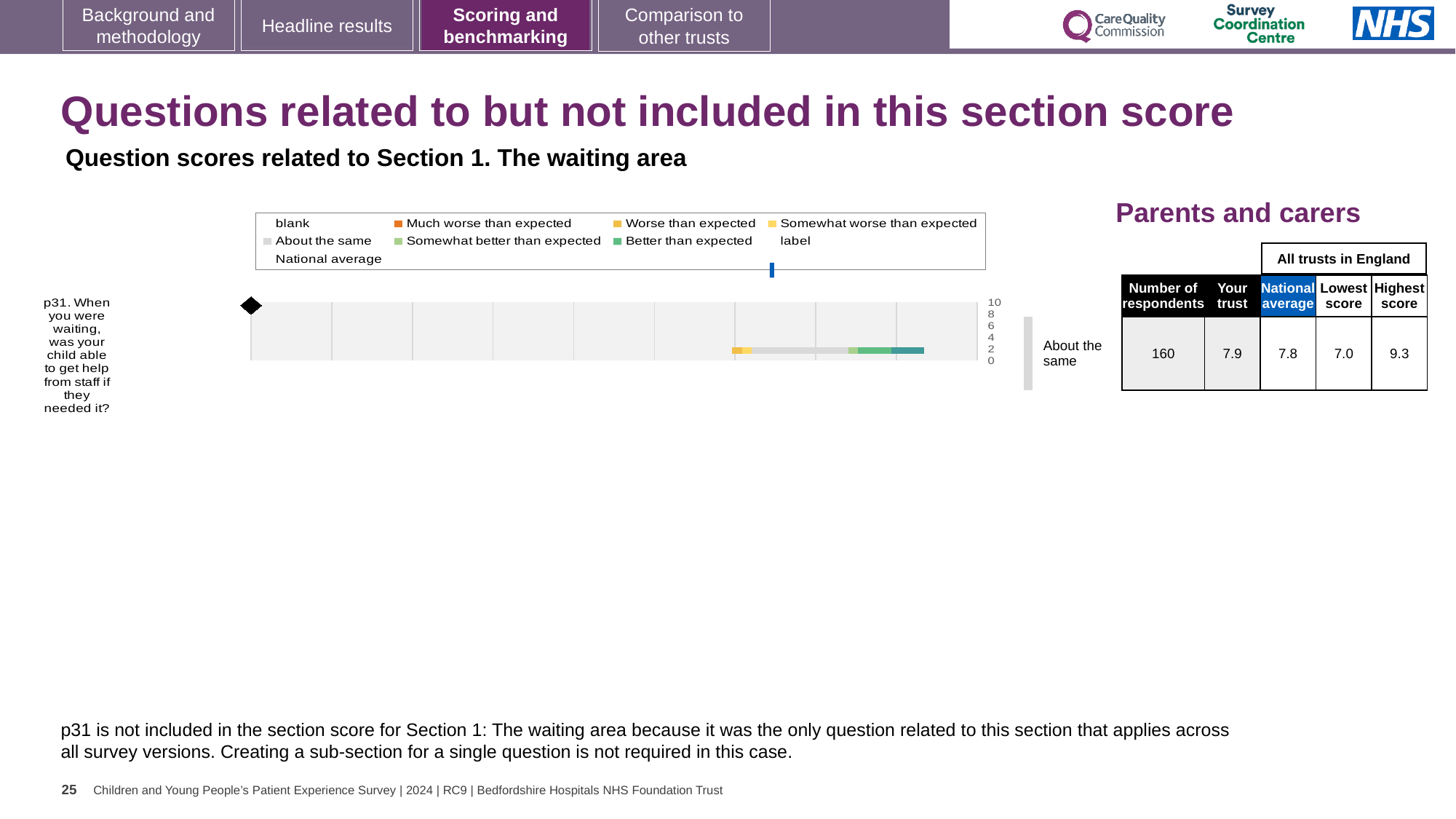
What is the difference between the highest score and the lowest score for p31 in the table? 2.3 Which benchmark category is the trust's result for p31 labelled as in the chart? About the same Which is larger for p31, the 'Your trust' score or the national average? Your trust How many respondents answered p31 according to the table? 160 What kind of chart is used to show the p31 question score? Bar chart What is the 'Your trust' score for p31 in the Parents and carers table? 7.9 How many entries does the chart legend list? 9 What is the highest score among all trusts in England for p31? 9.3 Which question number is plotted in the chart? p31 What is the national average score for p31 in the Parents and carers table? 7.8 How many questions are plotted in the chart? 1